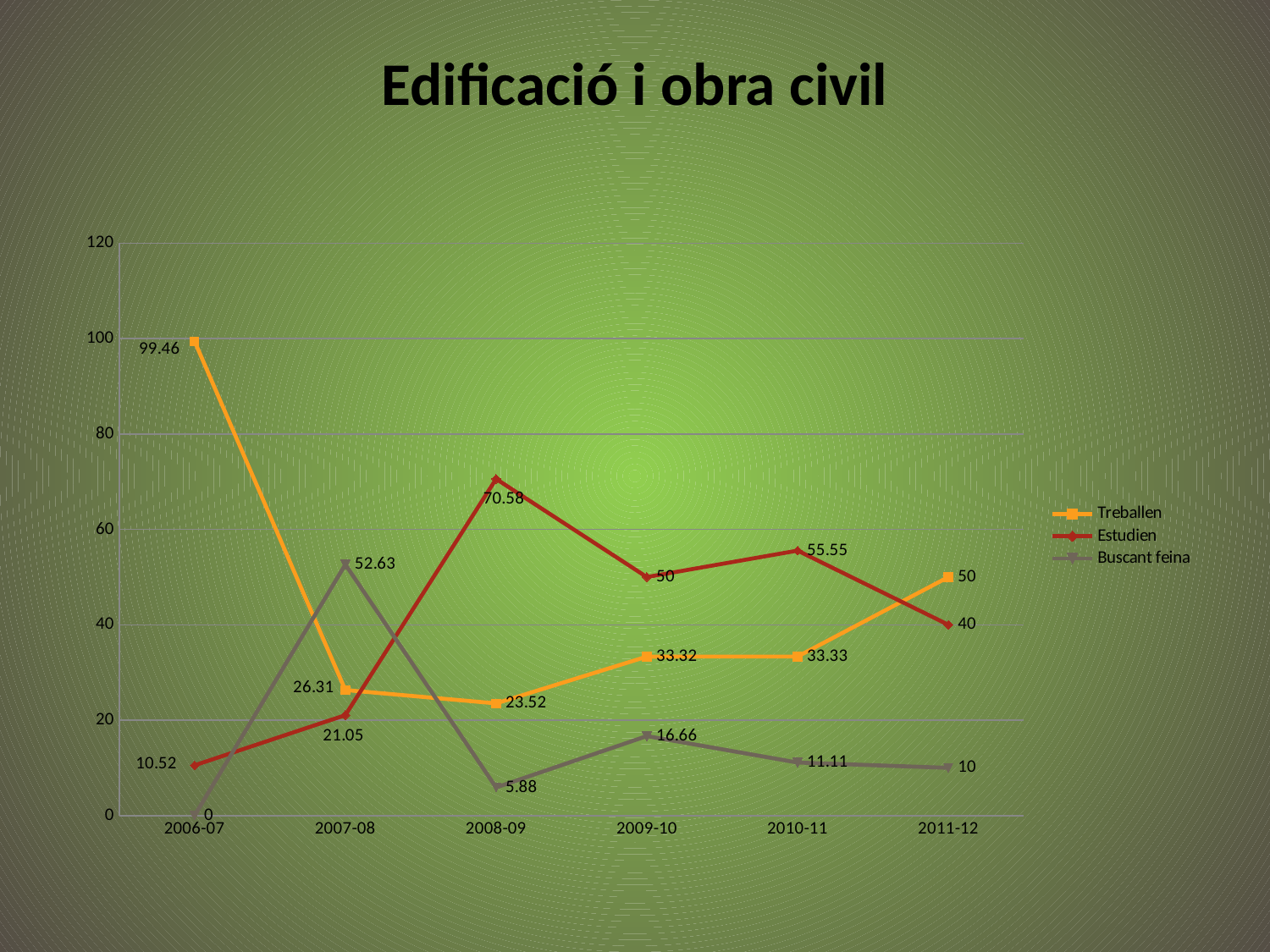
What is the title of the chart? Edificació i obra civil What is the value for Treballen in 2006-07? 99.46 Which series has the larger value in 2010-11, Estudien or Treballen? Estudien What is the value for Buscant feina in 2007-08? 52.63 Does the Treballen series rise or fall from 2006-07 to 2007-08? fall What is the value for Estudien in 2008-09? 70.58 How many series does the legend list? 3 What type of chart is shown on the slide? line chart How many academic years are shown on the x axis? 6 In which year is the Estudien series at its highest? 2008-09 In which year is the Buscant feina series at its lowest? 2006-07 What is the difference between Estudien and Treballen in 2011-12? -10